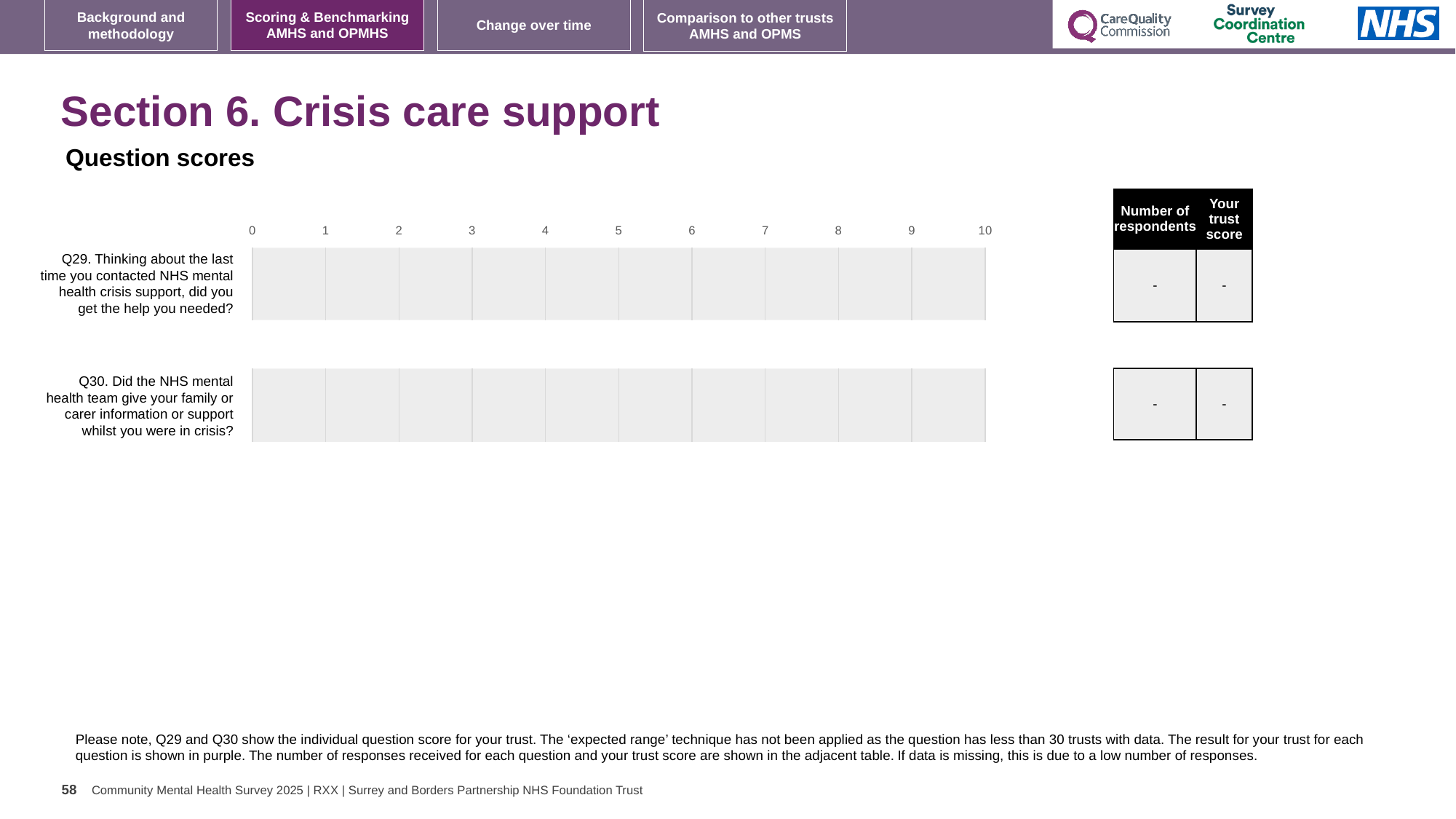
What is the heading shown above the chart? Question scores How many questions are listed as categories on the chart? 2 What is shown in the 'Number of respondents' column for Q30 in the table next to the chart? - What is the highest value shown on the chart's horizontal axis? 10 Which question label appears first (at the top) on the chart? Q29. Thinking about the last time you contacted NHS mental health crisis support, did you get the help you needed? What is shown in the 'Your trust score' column for Q29 in the table next to the chart? -